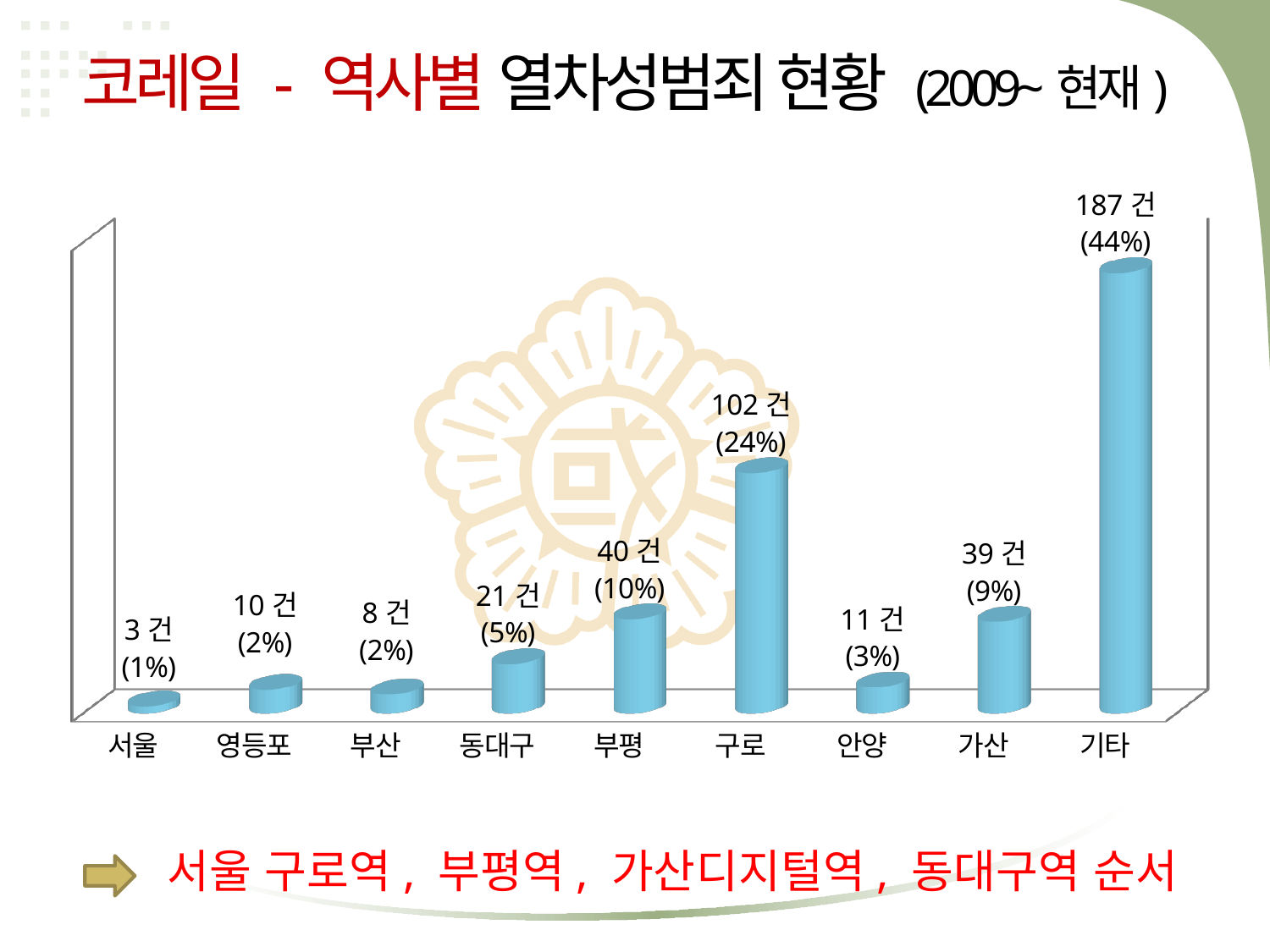
Which is larger, the value for 영등포 or the value for 부산? 영등포 Which category has the lowest value? 서울 What kind of chart is shown on the slide? Bar chart What is the value for 구로? 102 건 Which category has the highest value? 기타 What is the difference between the values for 부평 and 가산? 1 건 What is the value for 동대구? 21 건 What percentage is shown for 기타? 44% What is the title of the chart on the slide? 코레일 - 역사별 열차성범죄 현황 (2009~ 현재) How many categories are shown on the x axis? 9 What is the difference between the values for 기타 and 구로? 85 건 What is the value for 부평? 40 건